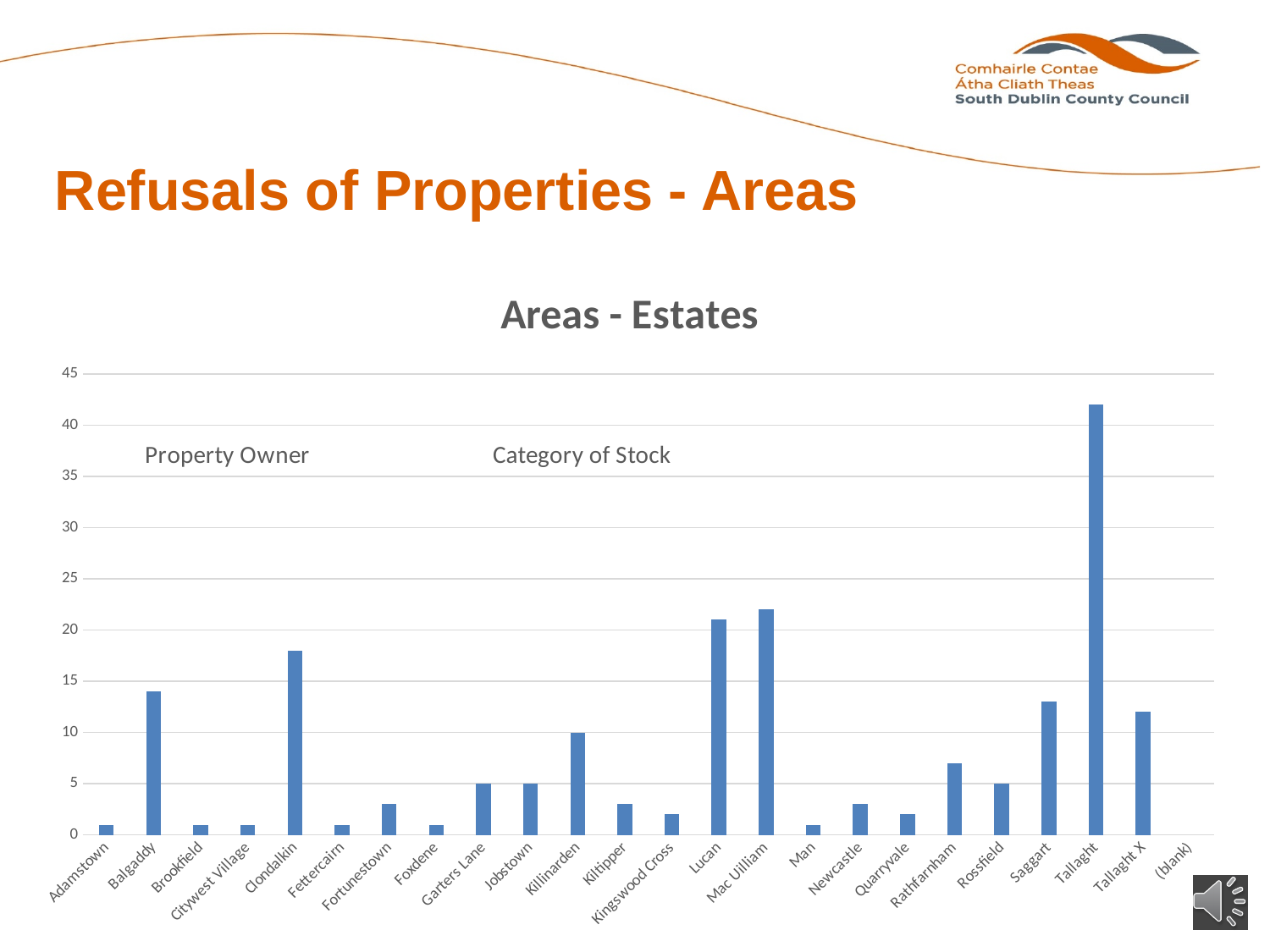
What is the value for Rossfield? 5 Which is larger, the value for Clondalkin or the value for Balgaddy? Clondalkin What is the title of the chart? Areas - Estates What is the value for Killinarden? 10 Which area has the highest value in the chart? Tallaght Is the value for Tallaght greater or less than 40? greater What is the value for Garters Lane? 5 Is the value for Rathfarnham greater or less than 10? less Is the value for Lucan greater or less than 20? greater How many categories are shown on the x axis of the chart? 24 What kind of chart is shown on the slide? bar chart